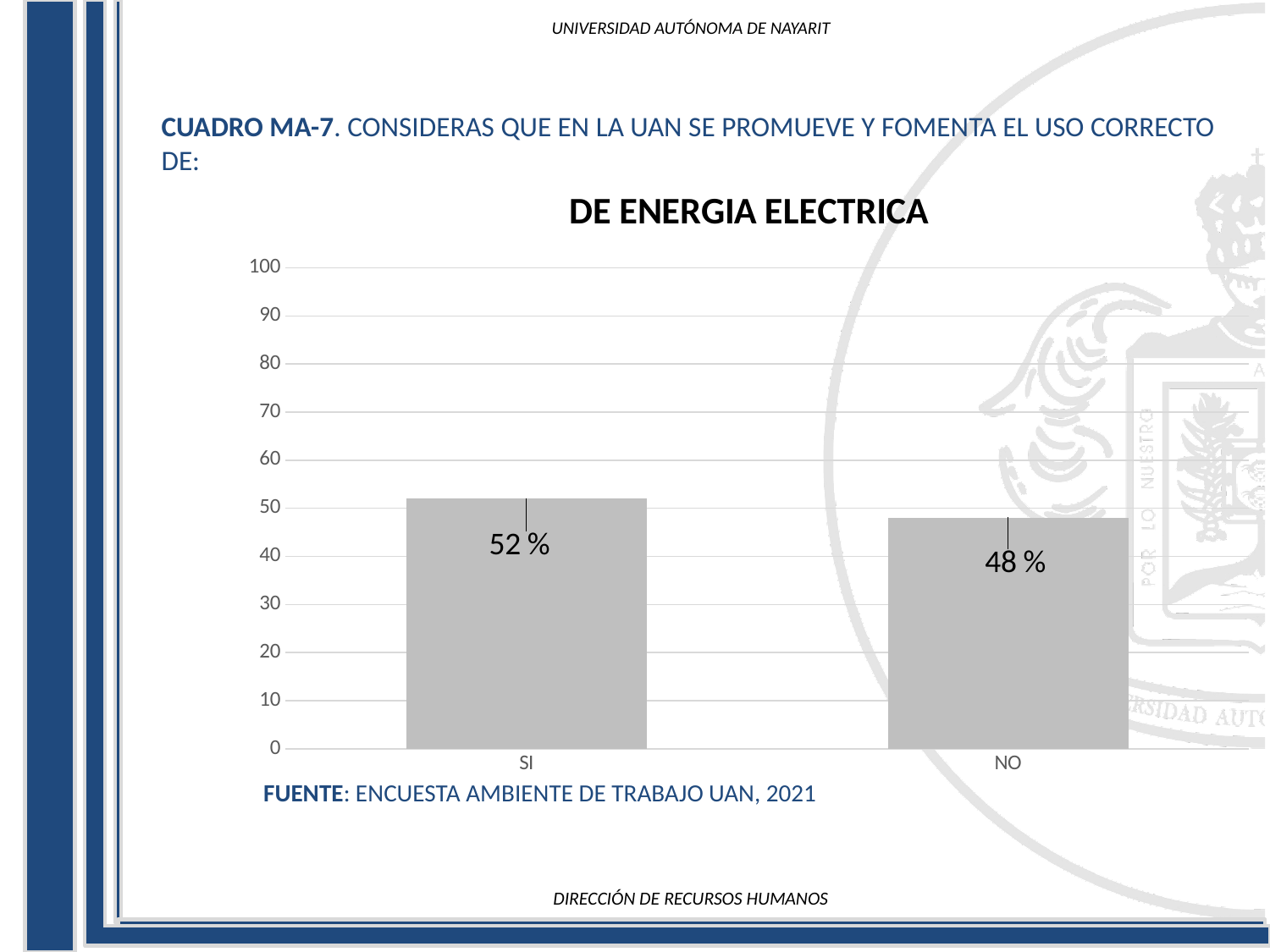
What is the maximum value shown on the y axis? 100 Which is larger, the value for SI or the value for NO? SI What is the value for NO? 48 % Is the value for SI greater or less than 50? greater What kind of chart is shown on the slide? bar chart What is the difference between the values for SI and NO? 4 % What is the title of the chart? DE ENERGIA ELECTRICA Which category has the lowest value? NO How many categories are shown on the x axis? 2 Which category has the highest value? SI Is the value for NO greater or less than 50? less What is the value for SI? 52 %